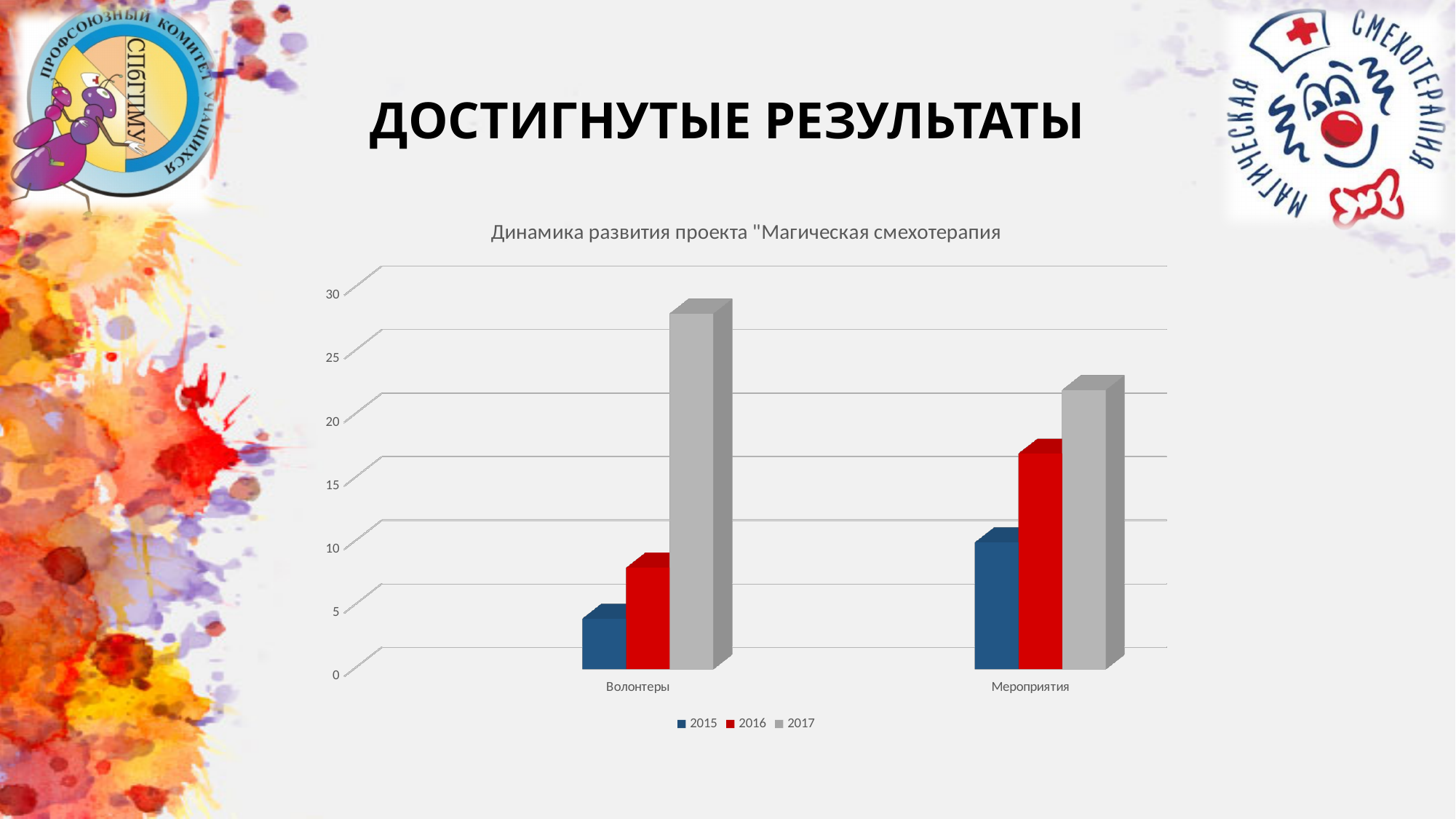
Which series has the highest bar for Волонтеры? 2017 How many series does the chart legend list? 3 Is the 2017 value for Волонтеры greater or less than 25? greater Which colour represents the 2017 series in the chart? Grey Which series has the lowest bar for Мероприятия? 2015 Is the 2016 value for Волонтеры greater or less than 10? less Which is larger: the 2017 value for Волонтеры or the 2017 value for Мероприятия? Волонтеры How many categories are shown on the x axis of the chart? 2 What is the title of the chart? Динамика развития проекта "Магическая смехотерапия Do the values for Мероприятия rise or fall from 2015 to 2017? Rise What kind of chart is shown on the slide? Bar chart Is the 2016 value for Мероприятия greater or less than 15? greater